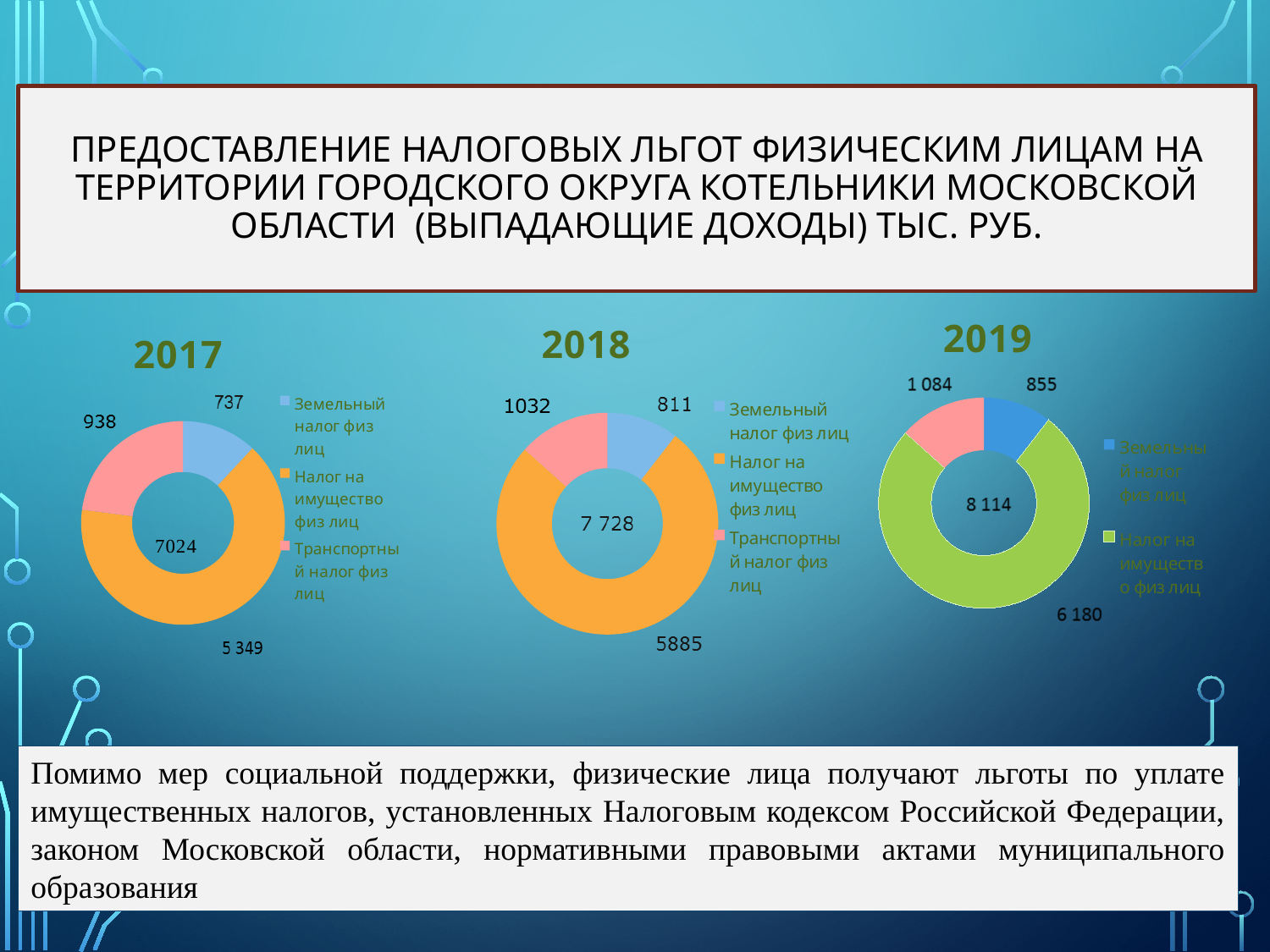
In the 2018 chart, which category has the smallest value? Земельный налог физ лиц In the 2017 chart, what is the value for Налог на имущество физ лиц? 5 349 In the 2017 chart, which category has the largest value? Налог на имущество физ лиц What type of chart is the 2017 chart? Doughnut chart In the 2018 chart, what value is shown in the centre of the doughnut? 7 728 In the 2019 chart, which is larger: Налог на имущество физ лиц or Земельный налог физ лиц? Налог на имущество физ лиц In the 2019 chart, what is the value for Земельный налог физ лиц? 855 How many entries does the legend of the 2019 chart list? 2 How many slices does the 2018 chart have? 3 In the 2018 chart, what is the value for Транспортный налог физ лиц? 1032 In the 2018 chart, what is the difference between Транспортный налог физ лиц and Земельный налог физ лиц? 221 In the 2017 chart, what is the difference between Транспортный налог физ лиц and Земельный налог физ лиц? 201